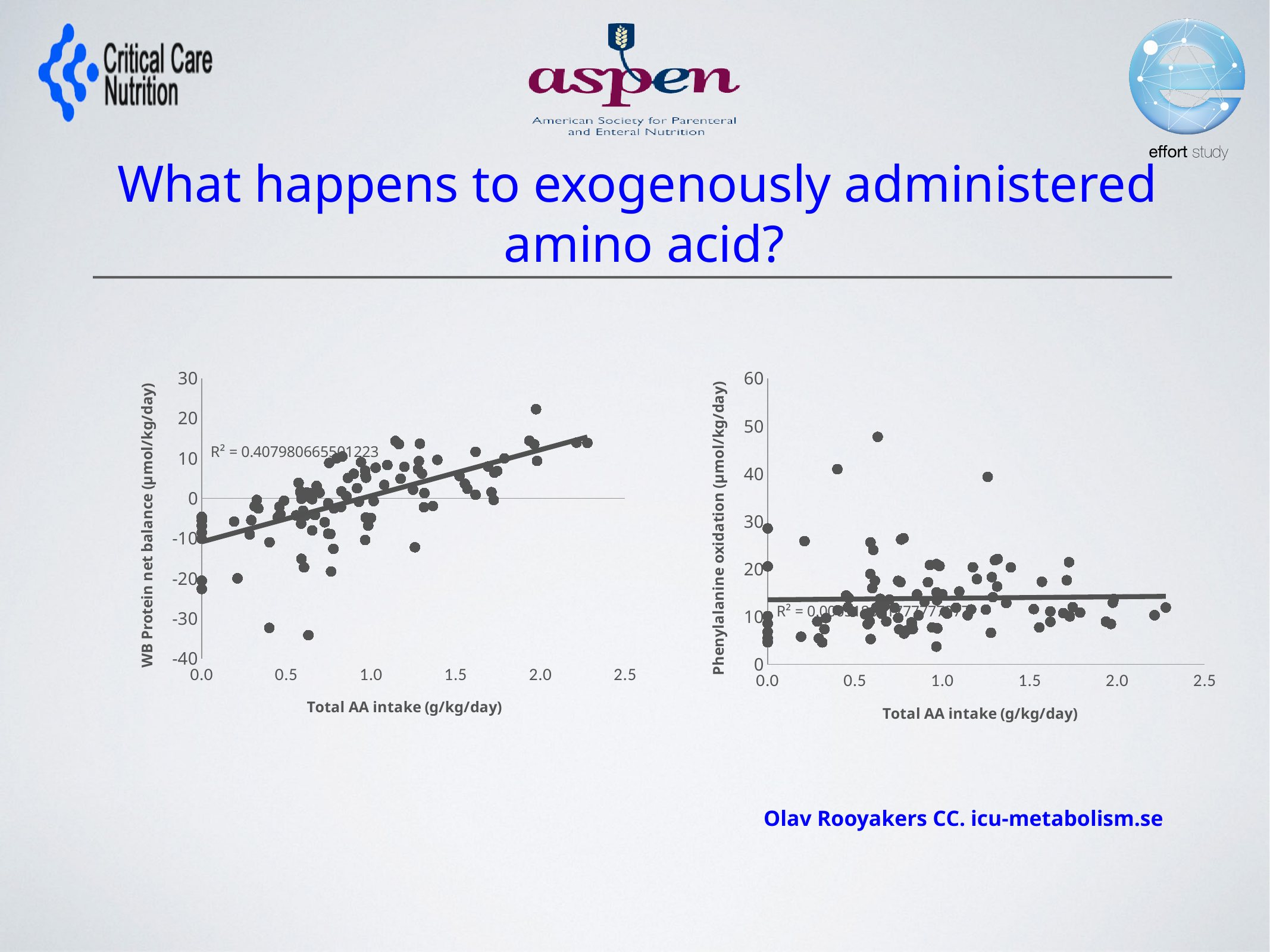
On the right chart, does the trend line rise steeply, fall steeply, or stay roughly flat as Total AA intake increases? Roughly flat What is the x-axis label on the left chart? Total AA intake (g/kg/day) On the left chart, does the trend line rise or fall as Total AA intake increases? Rises What is the maximum value shown on the y-axis of the right chart? 60 On the left chart, what R² value is printed for the trend line? R² = 0.407980665501223 What kind of chart is the right chart (Phenylalanine oxidation vs Total AA intake)? Scatter chart On the left chart, is the lowest plotted point greater or less than -30 on the y-axis? less What is the maximum value shown on the x-axis of the left chart? 2.5 On the left chart, is the highest plotted point greater or less than 20 on the y-axis? greater What is the y-axis label on the right chart? Phenylalanine oxidation (µmol/kg/day) What kind of chart is the left chart (WB Protein net balance vs Total AA intake)? Scatter chart On the right chart, is the highest plotted point greater or less than 40 on the y-axis? greater